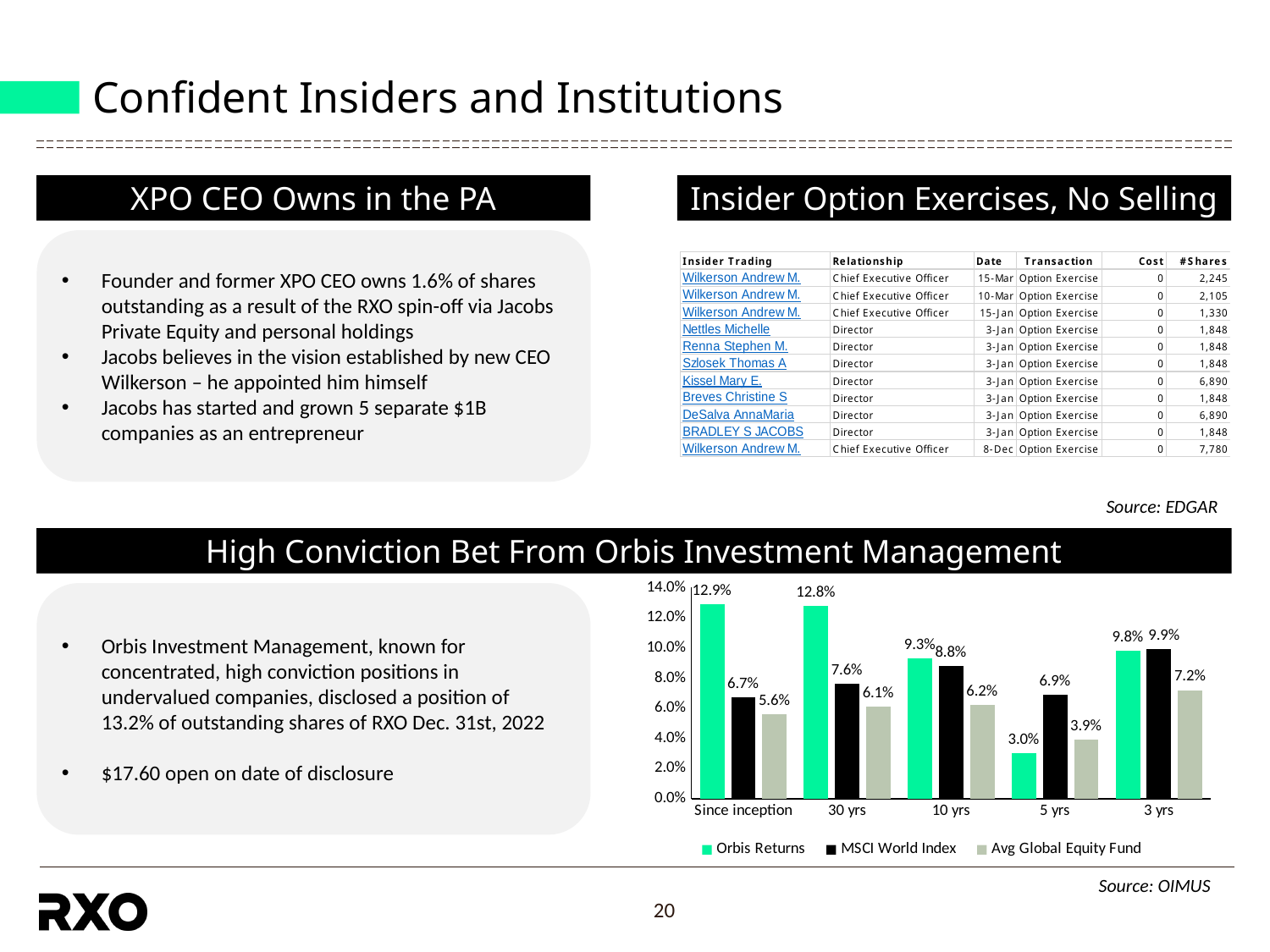
How many categories are shown on the x axis of the chart? 5 Is the Orbis Returns value for '10 yrs' greater or less than 8.0%? greater Which category has the lowest Orbis Returns value? 5 yrs For the '5 yrs' category, which is larger: Orbis Returns or the MSCI World Index? MSCI World Index What kind of chart is shown under 'High Conviction Bet From Orbis Investment Management'? Bar chart What is the Avg Global Equity Fund value for the '3 yrs' category? 7.2% What is the Orbis Returns value for the 'Since inception' category? 12.9% What is the title of the section containing the chart? High Conviction Bet From Orbis Investment Management Which category has the highest MSCI World Index value? 3 yrs What is the difference between Orbis Returns and the MSCI World Index for the '30 yrs' category? 5.2% What is the MSCI World Index value for the '5 yrs' category? 6.9% How many series does the chart legend list? 3